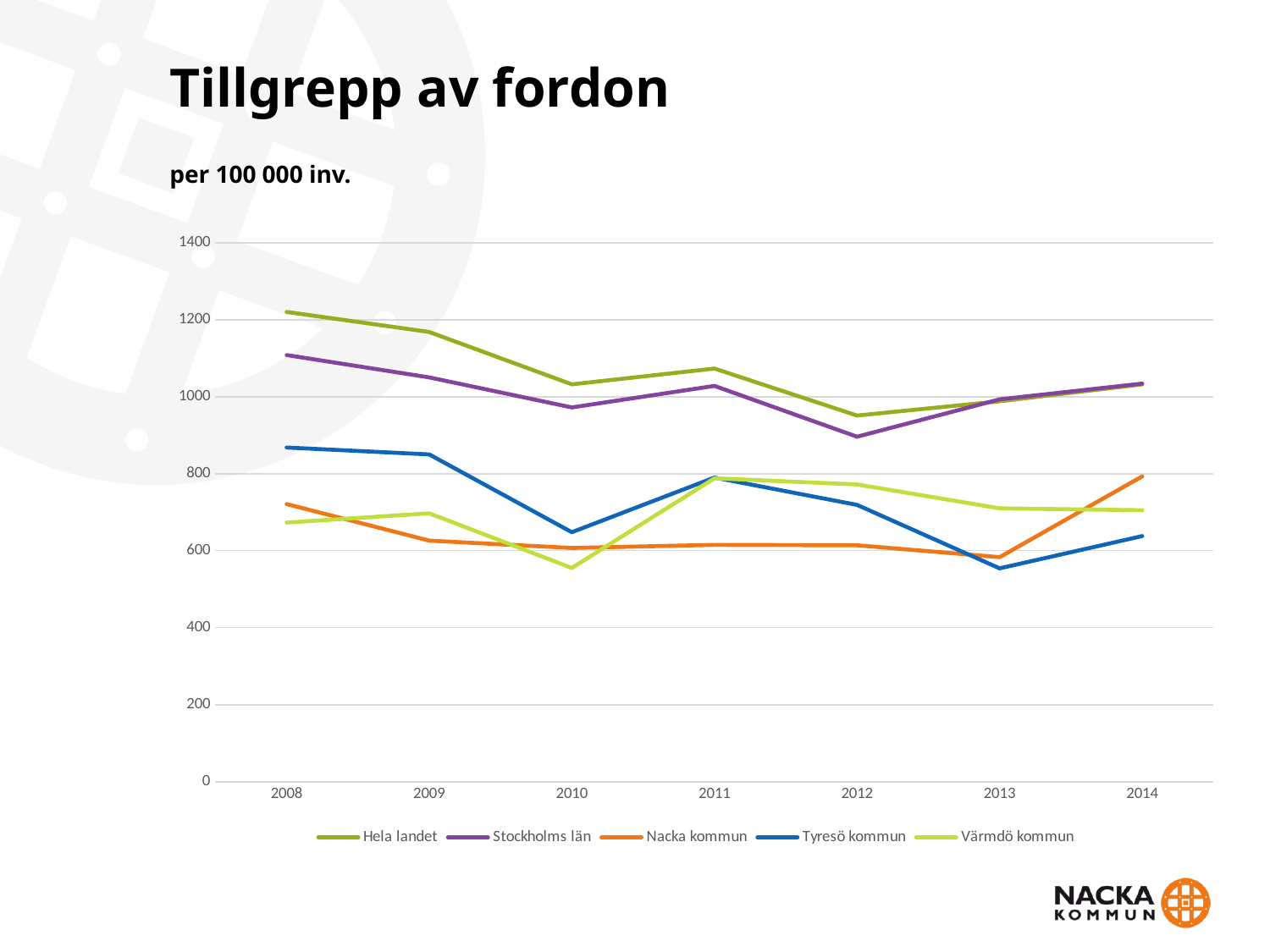
In 2008, which is larger: Tyresö kommun or Nacka kommun? Tyresö kommun Does the Hela landet line rise or fall from 2008 to 2010? fall Is the value for Nacka kommun in 2010 greater or less than 800? less Which series has the highest value in 2008? Hela landet How many series does the legend list? 5 What is the title of the chart? Tillgrepp av fordon Is the value for Stockholms län in 2012 greater or less than 1000? less How many years are shown on the x axis? 7 What kind of chart is shown on the slide? line chart In 2014, which is larger: Nacka kommun or Värmdö kommun? Nacka kommun Which series has the lowest value in 2010? Värmdö kommun Is the value for Hela landet in 2008 greater or less than 1000? greater